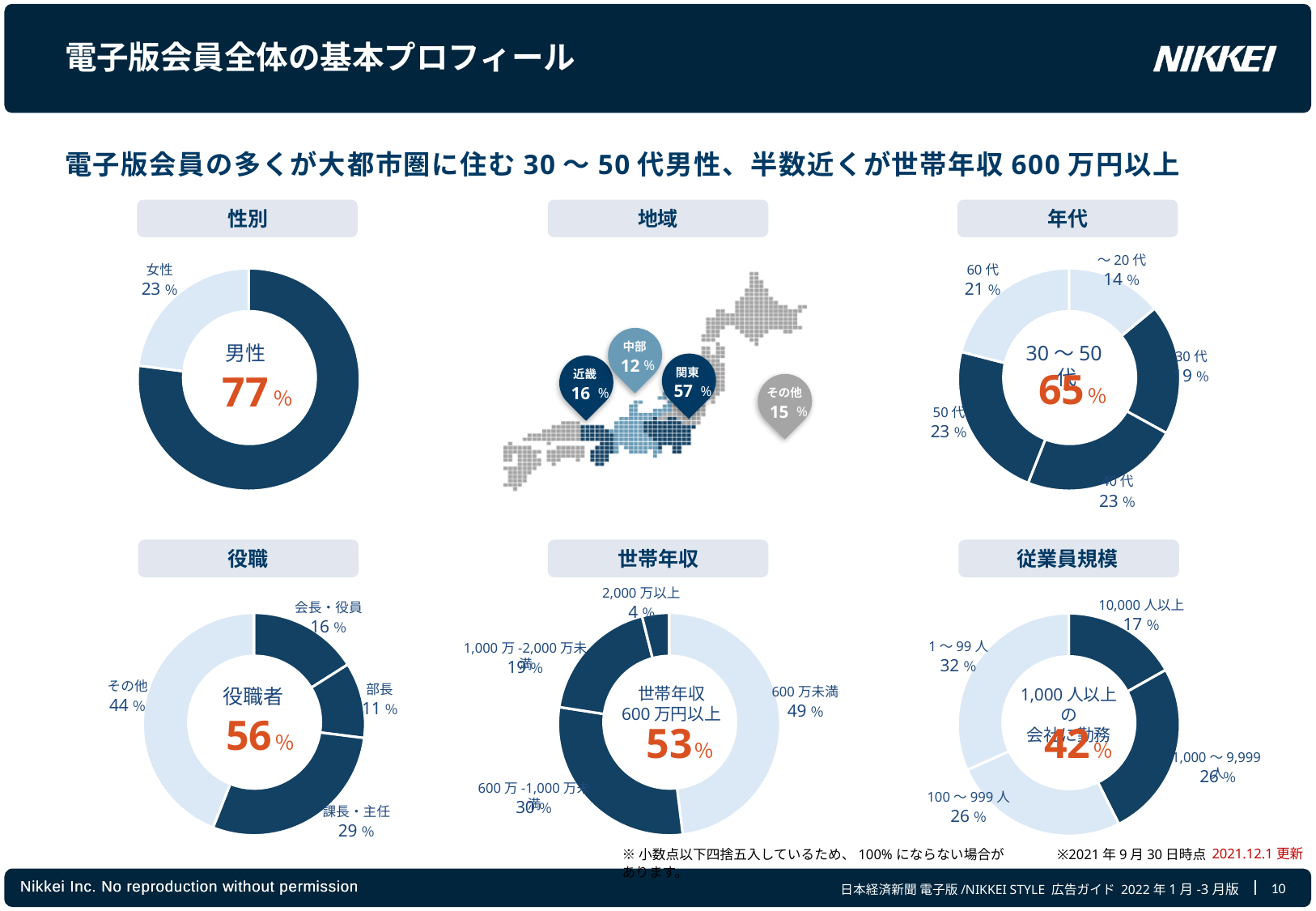
In the 世帯年収 chart, which category has the smallest share? 2,000万以上 In the 年代 chart, what percentage is 60代? 21% In the 役職 chart, what percentage is 課長・主任? 29% In the 性別 chart, what percentage is 女性? 23% In the 役職 chart, what is the difference between その他 and 会長・役員? 28% In the 年代 chart, which age group has the smallest share? ～20代 In the 従業員規模 chart, which category has the largest share? 1～99人 In the 世帯年収 chart, what percentage is 600万未満? 49% In the 地域 map, which region has the largest share, and what is its value? 関東, 57% In the 性別 chart, what percentage is 男性? 77% What kind of chart is used for 性別? Donut (pie) chart In the 年代 chart, how many age categories are shown? 5